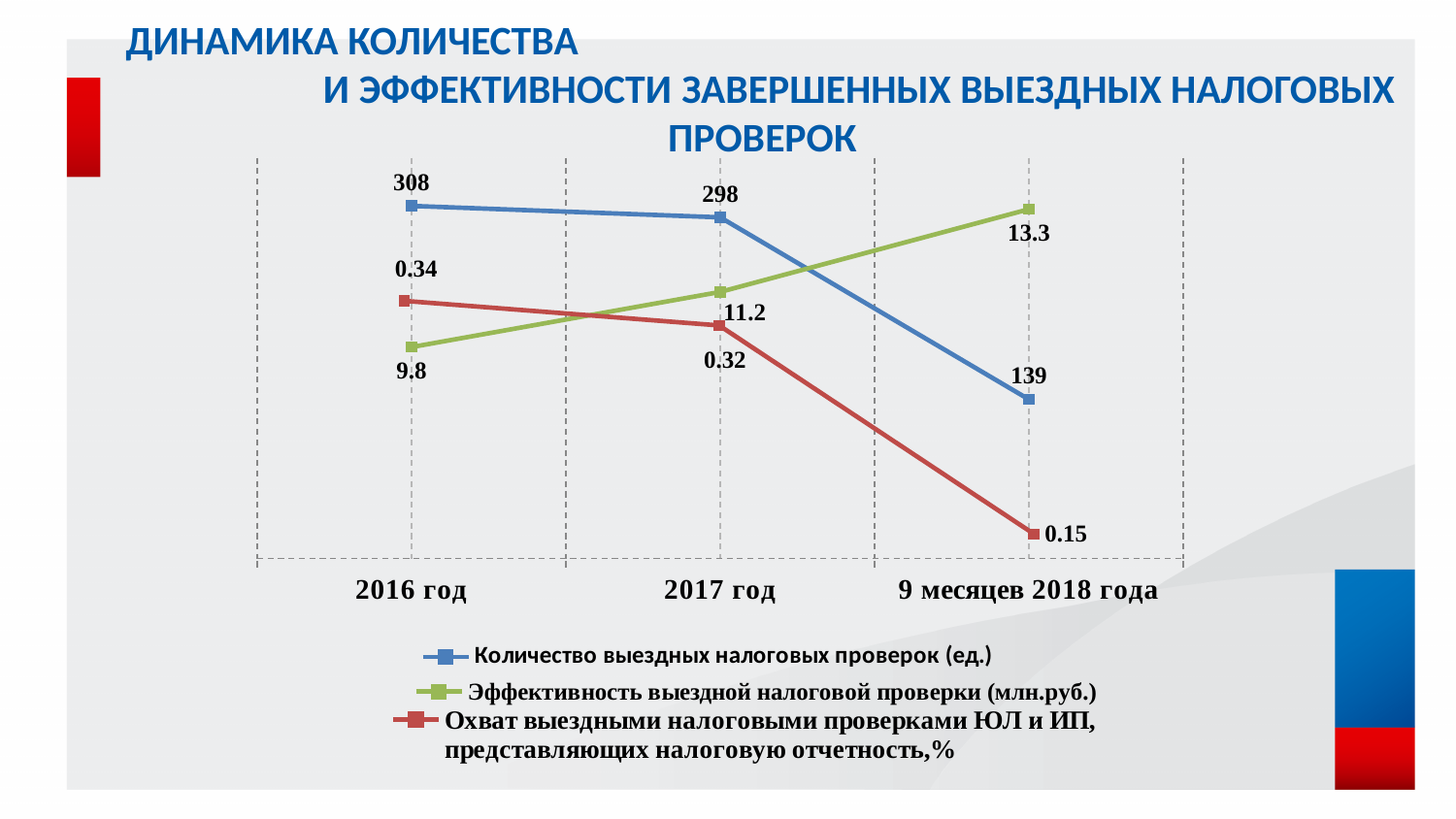
What type of chart is shown on the slide? line chart What is the value of 'Количество выездных налоговых проверок (ед.)' for 9 месяцев 2018 года? 139 What is the value of 'Эффективность выездной налоговой проверки (млн.руб.)' for 2017 год? 11.2 In which category is 'Количество выездных налоговых проверок (ед.)' lowest? 9 месяцев 2018 года Which series is drawn in red? Охват выездными налоговыми проверками ЮЛ и ИП, представляющих налоговую отчетность,% How many series does the legend list? 3 Does 'Эффективность выездной налоговой проверки (млн.руб.)' rise or fall from 2016 год to 9 месяцев 2018 года? rise How many categories are shown on the x axis? 3 What is the difference between the 'Количество выездных налоговых проверок (ед.)' values for 2016 год and 2017 год? 10 In which category is 'Эффективность выездной налоговой проверки (млн.руб.)' highest? 9 месяцев 2018 года What is the value of 'Количество выездных налоговых проверок (ед.)' for 2016 год? 308 What is the value of 'Охват выездными налоговыми проверками ЮЛ и ИП, представляющих налоговую отчетность,%' for 2016 год? 0.34